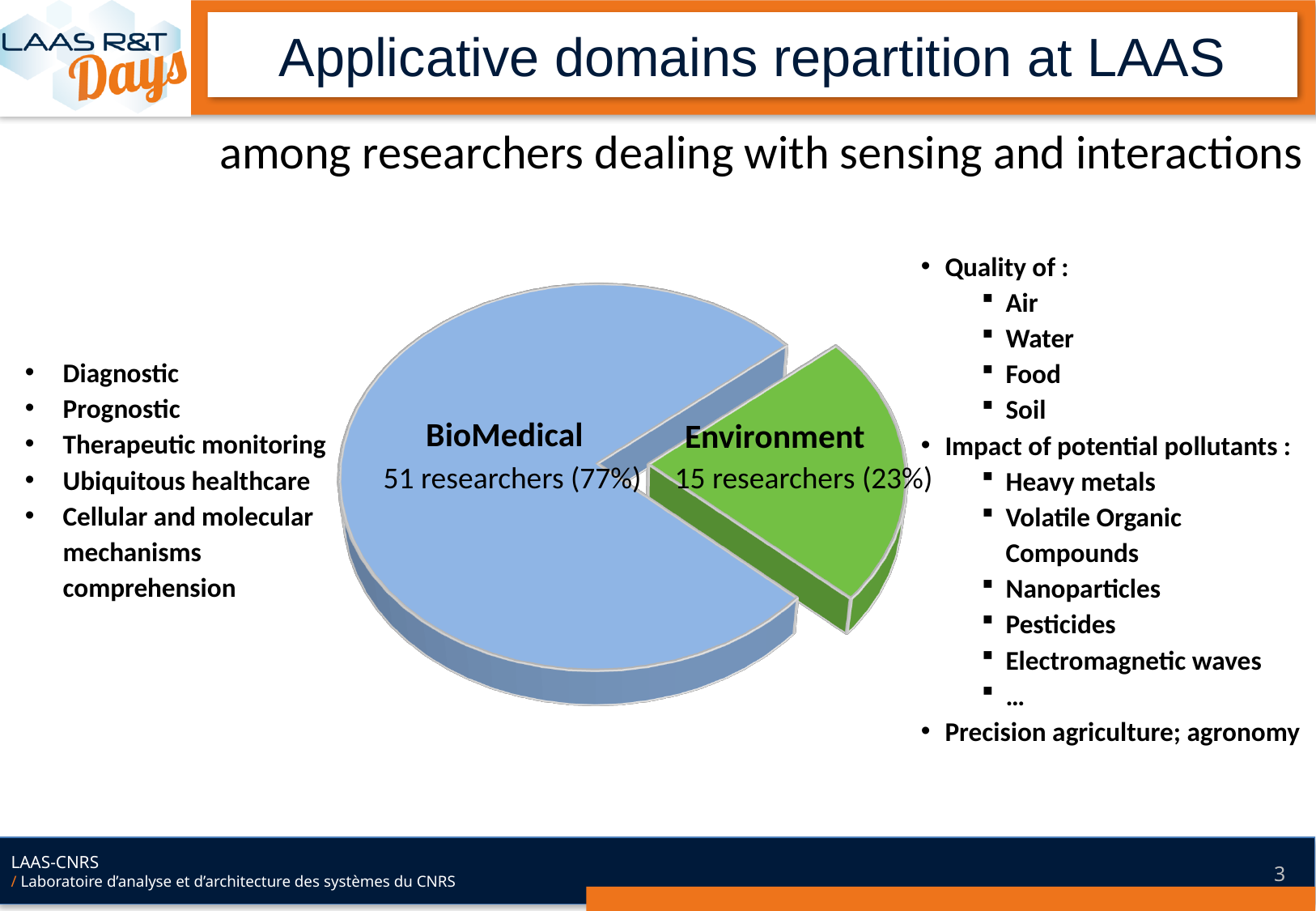
Which has more researchers, BioMedical or Environment? BioMedical How many slices does the pie chart have? 2 What colour is the Environment slice of the pie chart? green What kind of chart is shown on the slide? pie chart How many researchers are in the Environment slice of the pie chart? 15 Which slice of the pie chart is the largest? BioMedical What percentage share does the Environment slice represent? 23% How many researchers are in the BioMedical slice of the pie chart? 51 What is the total number of researchers represented in the pie chart? 66 What is the difference in the number of researchers between BioMedical and Environment? 36 Which slice of the pie chart is the smallest? Environment What percentage share does the BioMedical slice represent? 77%